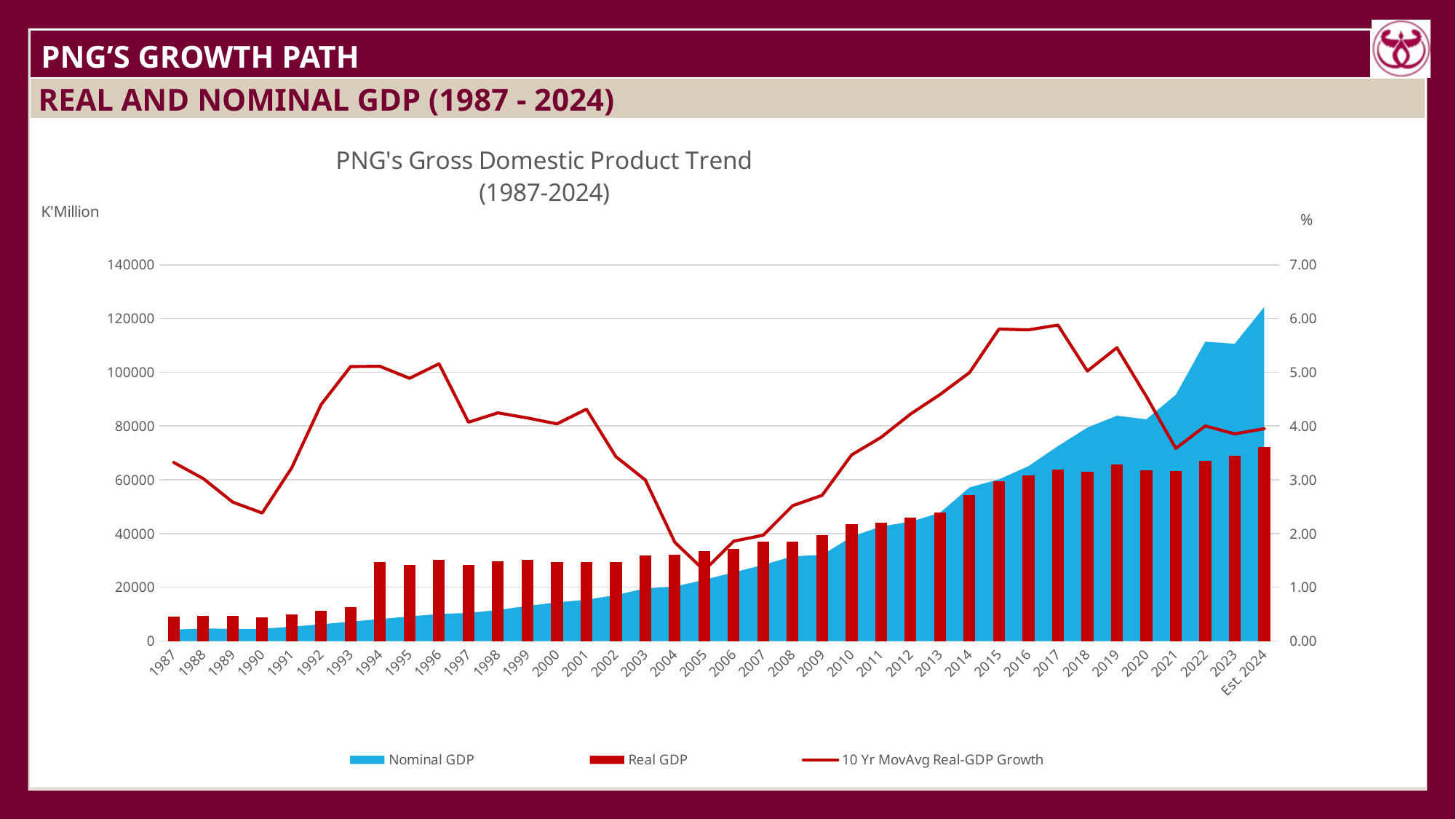
Is the 10 Yr MovAvg Real-GDP Growth value for 2017 greater or less than 5.00? greater Is the 10 Yr MovAvg Real-GDP Growth value for 2005 greater or less than 2.00? less What unit label is shown on the left vertical axis of the chart? K'Million How many series does the chart's legend list? 3 Is the Real GDP value for 1987 greater or less than 20000? less What kind of chart is shown on the slide? Combination chart (bar, area and line) Which year has the highest Real GDP bar? Est. 2024 What is the title of the chart on the slide? PNG's Gross Domestic Product Trend (1987-2024) How many years are shown along the x axis of the chart? 38 Which year has the lowest value on the 10 Yr MovAvg Real-GDP Growth line? 2005